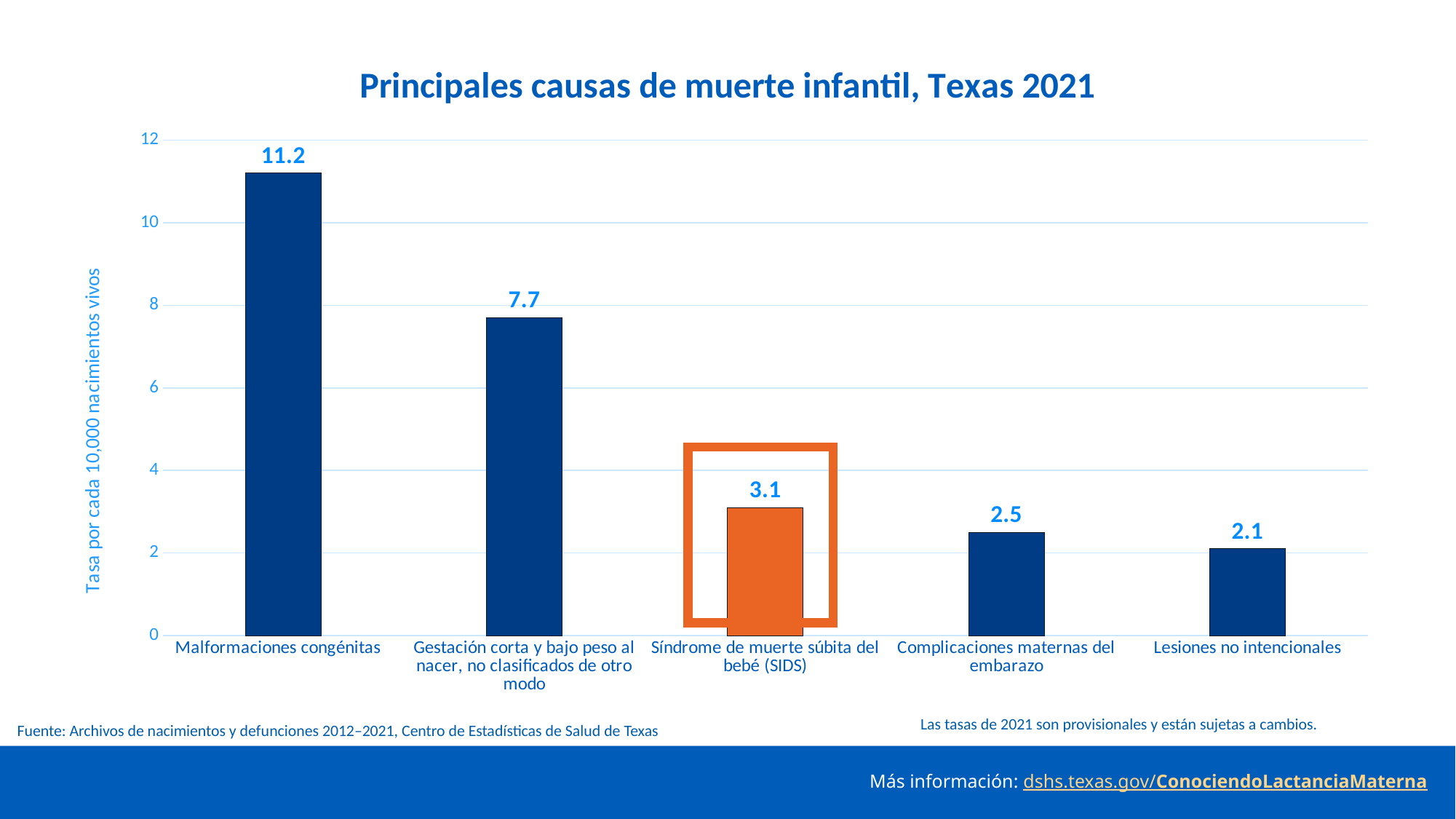
How many causes of death are shown in the chart? 5 Do the values rise or fall from left to right across the categories? fall Which bar is highlighted in orange? Síndrome de muerte súbita del bebé (SIDS) Is the value for Gestación corta y bajo peso al nacer, no clasificados de otro modo greater or less than 8? less What is the rate for Lesiones no intencionales? 2.1 Which is larger, the rate for Complicaciones maternas del embarazo or the rate for Lesiones no intencionales? Complicaciones maternas del embarazo What is the rate for Malformaciones congénitas? 11.2 Which cause has the highest rate? Malformaciones congénitas What is the rate for Síndrome de muerte súbita del bebé (SIDS)? 3.1 Which cause has the lowest rate? Lesiones no intencionales What kind of chart is shown on the slide? bar chart What is the difference between the rates for Malformaciones congénitas and Gestación corta y bajo peso al nacer, no clasificados de otro modo? 3.5